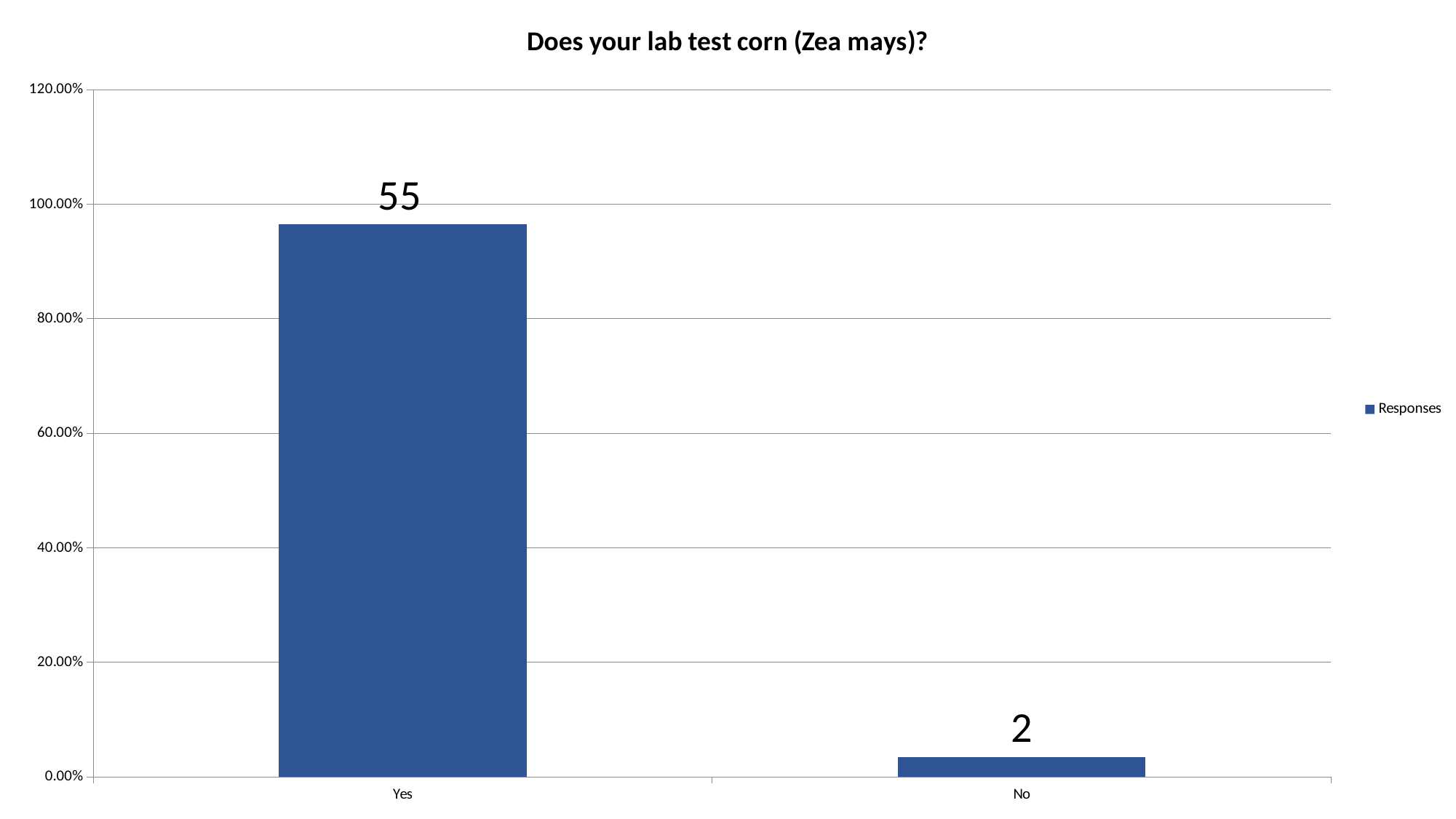
How many series does the legend list? 1 Which category has the lowest bar? No What data label is shown above the No bar? 2 Which category has the highest bar? Yes What is the difference between the data labels for Yes and No? 53 Is the value for Yes greater or less than 80.00% on the axis? greater Is the value for No greater or less than 20.00% on the axis? less What data label is shown above the Yes bar? 55 What kind of chart is shown on the slide? Bar chart Which is larger, the value for Yes or the value for No? Yes What is the title of the chart? Does your lab test corn (Zea mays)? How many categories are shown on the x axis? 2